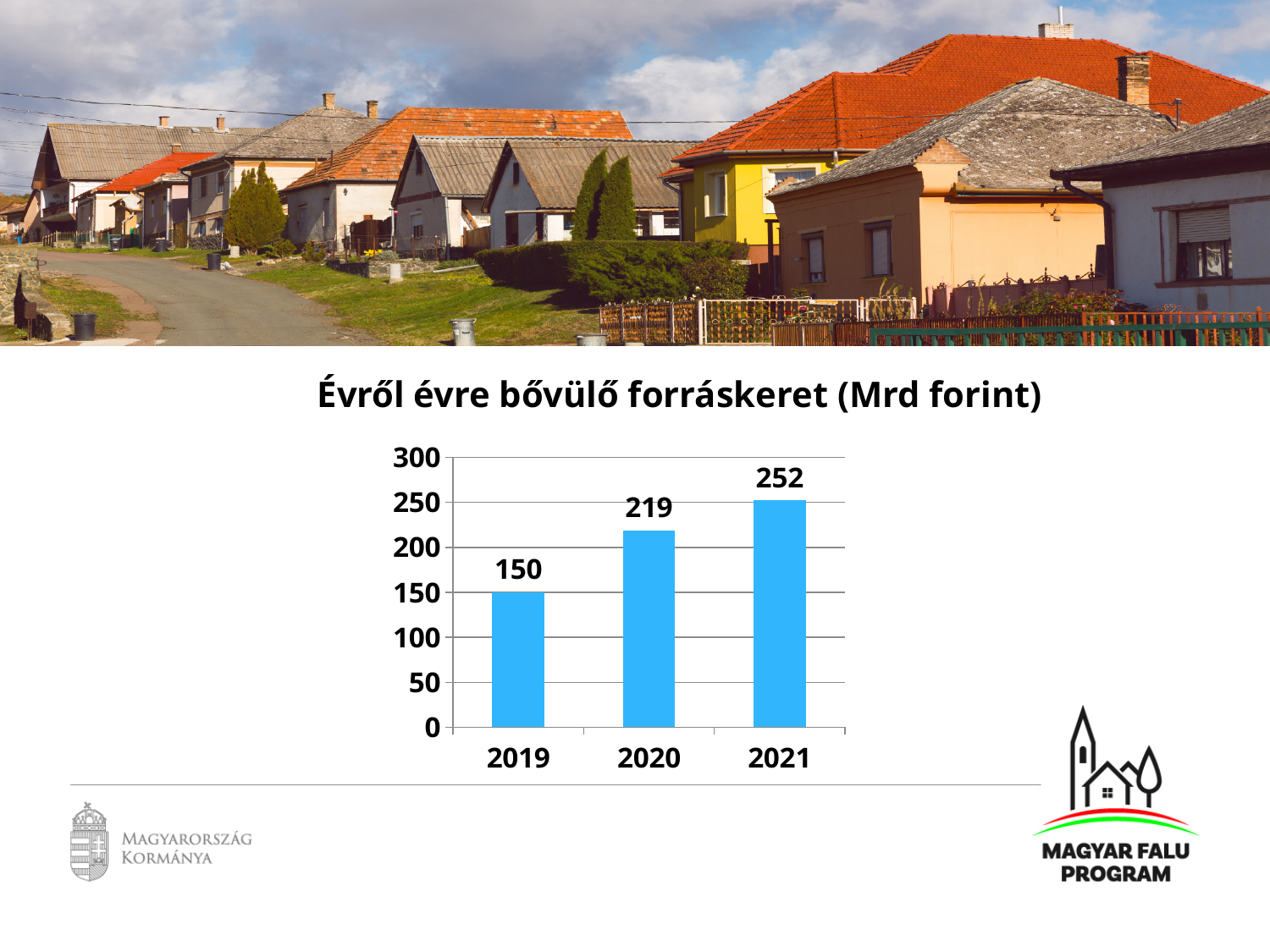
Which is larger, the value for 2020 or the value for 2021? 2021 Which year has the highest value? 2021 Do the values rise or fall from 2019 to 2021? rise How many years are shown on the chart? 3 Is the value for 2020 greater or less than 200? greater Which year has the lowest value? 2019 What kind of chart is shown on the slide? bar chart What is the value for 2020? 219 What is the value for 2021? 252 What is the difference between the values for 2021 and 2019? 102 What is the difference between the values for 2020 and 2019? 69 What is the value for 2019? 150